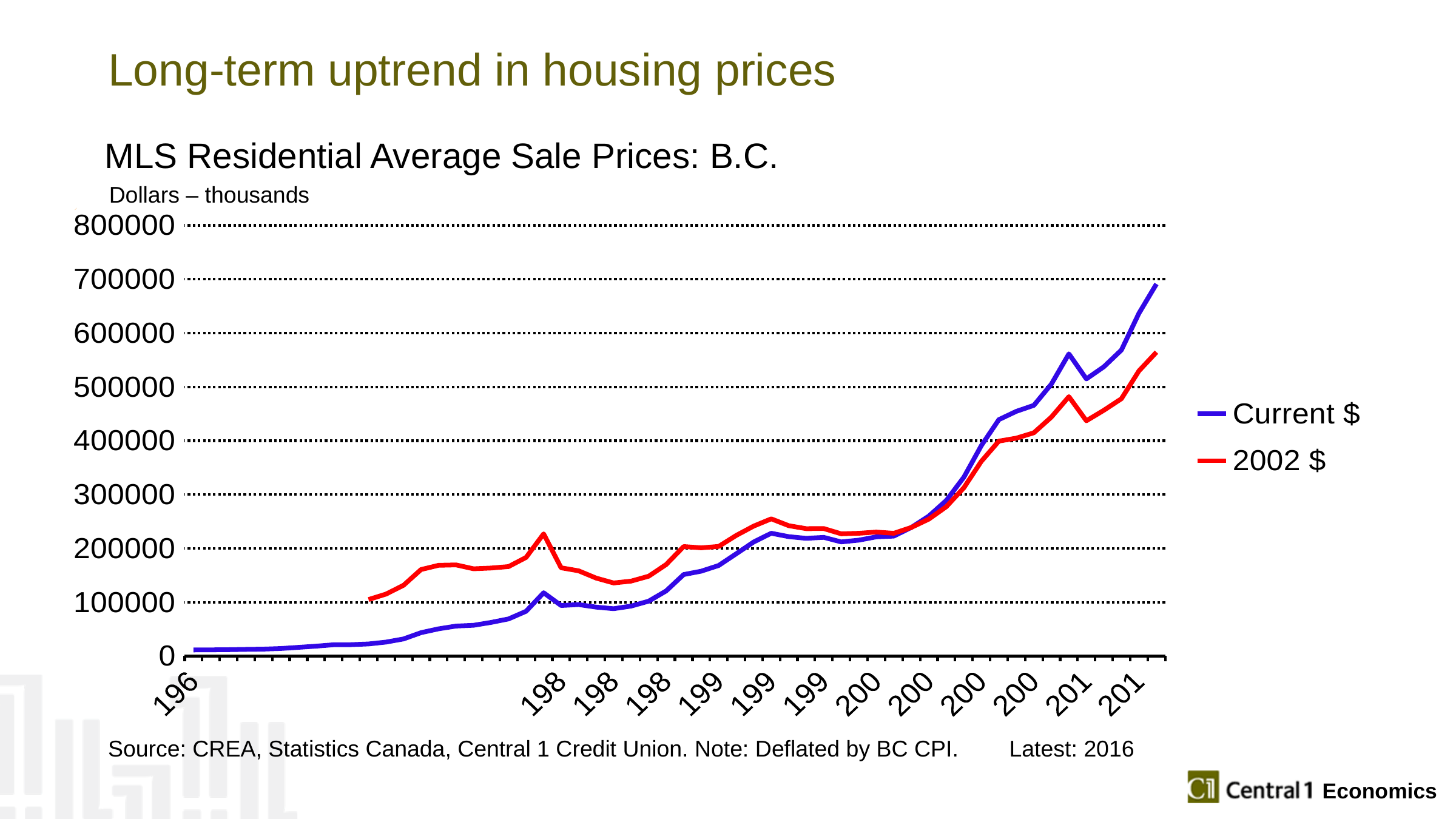
Is the final value of the Current $ series greater or less than 600000? greater At the right end of the chart, which series is higher, Current $ or 2002 $? Current $ What kind of chart is shown on the slide? line chart What is the title of the chart? MLS Residential Average Sale Prices: B.C. How many series does the legend list? 2 Is the final value of the 2002 $ series greater or less than 600000? less Is the final value of the 2002 $ series greater or less than 500000? greater What are the two series named in the legend? Current $ and 2002 $ Over the whole period, does the Current $ series generally rise or fall along the x axis? rise Which series reaches the highest value on the chart? Current $